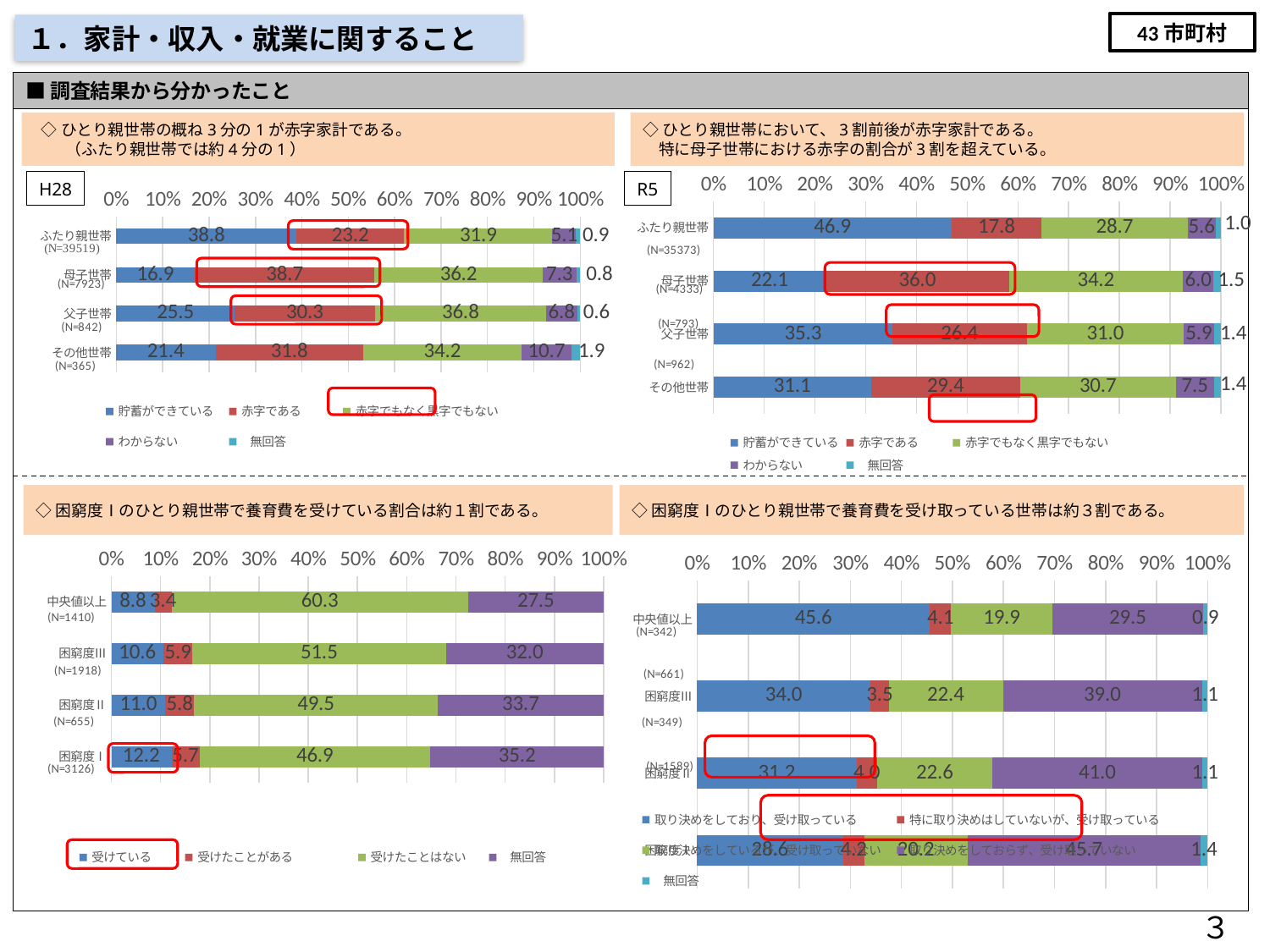
In the top-right R5 chart, which category has the lowest value for 赤字である? ふたり親世帯 In the bottom-left chart, what is the value of 受けている for 困窮度I? 12.2 In the bottom-left chart, what is the value of 受けたことはない for 中央値以上? 60.3 In the bottom-left chart, how many categories are shown? 4 What type of chart is the top-right R5 chart? Stacked bar chart In the top-right R5 chart, what is the value of 貯蓄ができている for ふたり親世帯? 46.9 In the bottom-right chart, what is the value of 取り決めをしており、受け取っている for 中央値以上? 45.6 How many series does the legend of the top-left H28 chart list? 5 In the top-right R5 chart, is the 赤字である value larger for 母子世帯 or 父子世帯? 母子世帯 In the top-left H28 chart, what is the difference between the 赤字である values for 母子世帯 and ふたり親世帯? 15.5 In the top-left H28 chart, which category has the highest value for 貯蓄ができている? ふたり親世帯 In the top-left H28 chart, what is the value of 赤字である for 母子世帯? 38.7